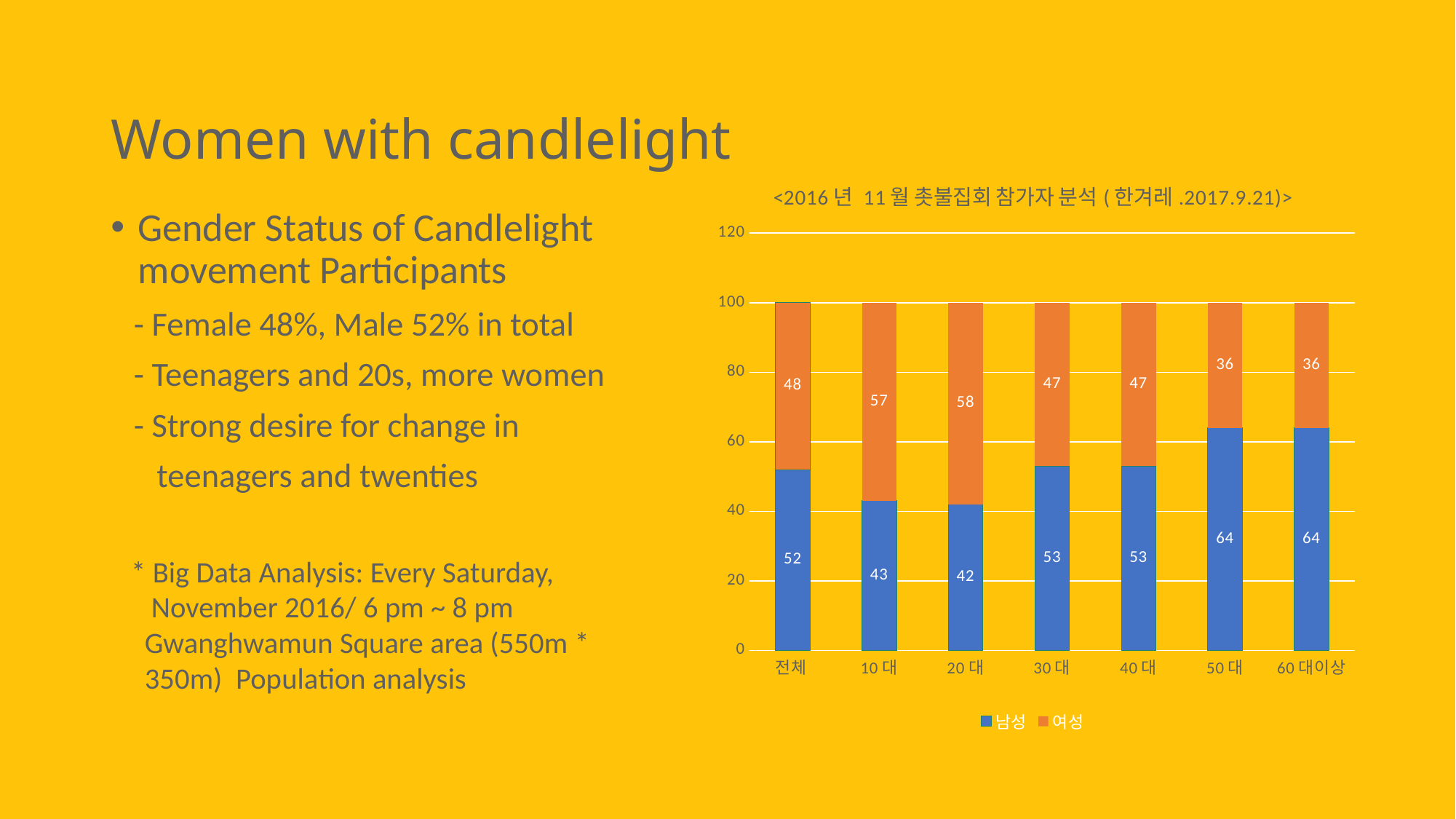
What kind of chart is shown on the slide? Stacked bar chart What is the 남성 value for 전체? 52 How many series does the legend list? 2 How many categories are shown on the x axis? 7 Which is larger for 10 대, the 남성 value or the 여성 value? 여성 Which category has the highest 여성 value? 20 대 What is the 여성 value for 10 대? 57 Which category has the lowest 남성 value? 20 대 What is the total of the stacked bar for 30 대? 100 What is the difference between the 남성 and 여성 values for 60 대이상? 28 What is the 여성 value for 20 대? 58 What is the 남성 value for 50 대? 64